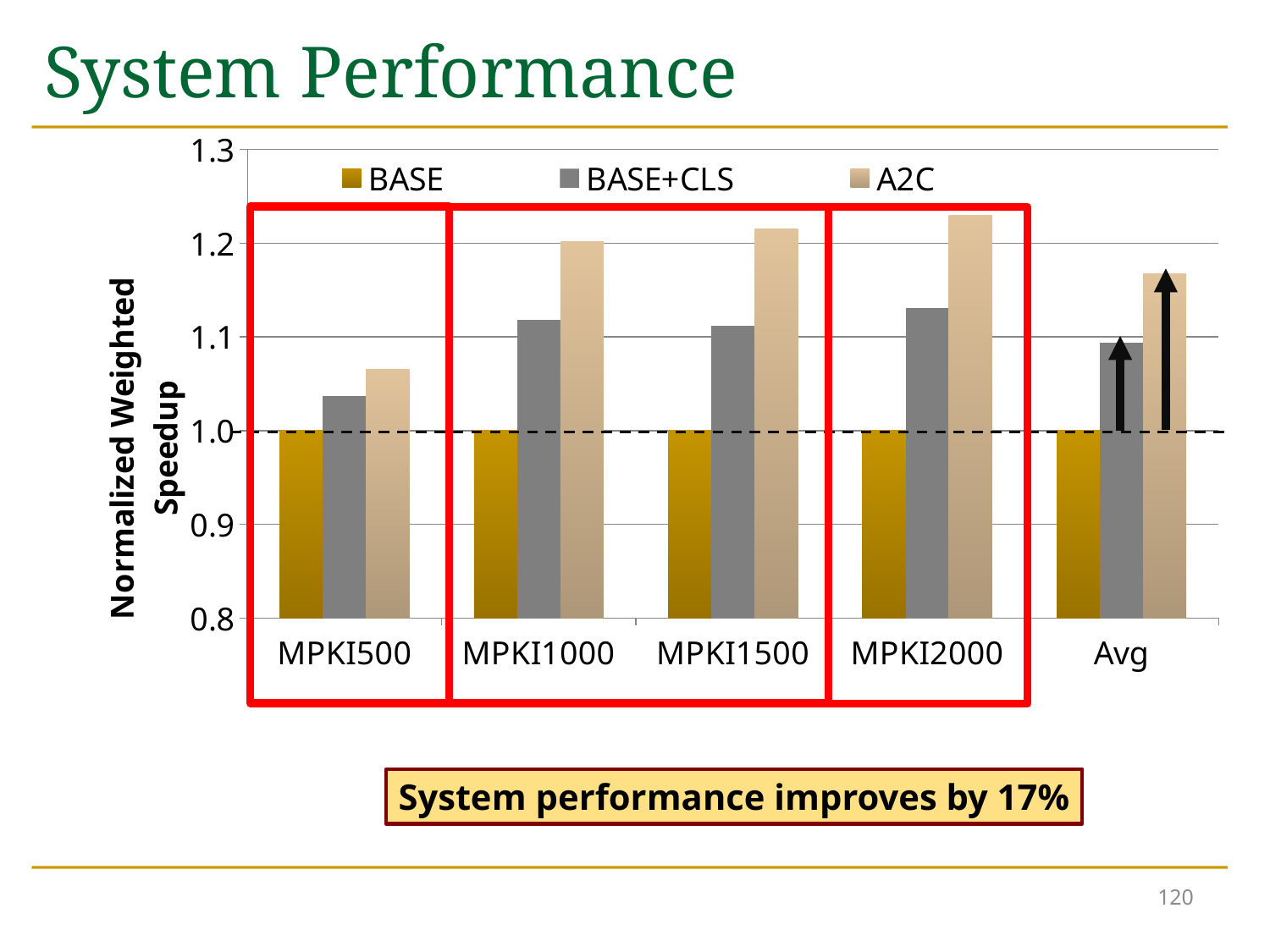
Is the A2C value for Avg greater or less than 1.2? less Is the A2C value for MPKI500 greater or less than 1.1? less How many categories are shown on the x axis? 5 Is the BASE+CLS value for MPKI1000 greater or less than 1.1? greater How many series does the legend list? 3 Do the A2C values rise or fall from MPKI500 to MPKI2000? rise For which category is the A2C value lowest? MPKI500 What is the label of the y axis? Normalized Weighted Speedup What kind of chart is shown on the slide? bar chart What is the BASE value for MPKI500? 1.0 For MPKI1000, which is larger: the A2C value or the BASE+CLS value? A2C